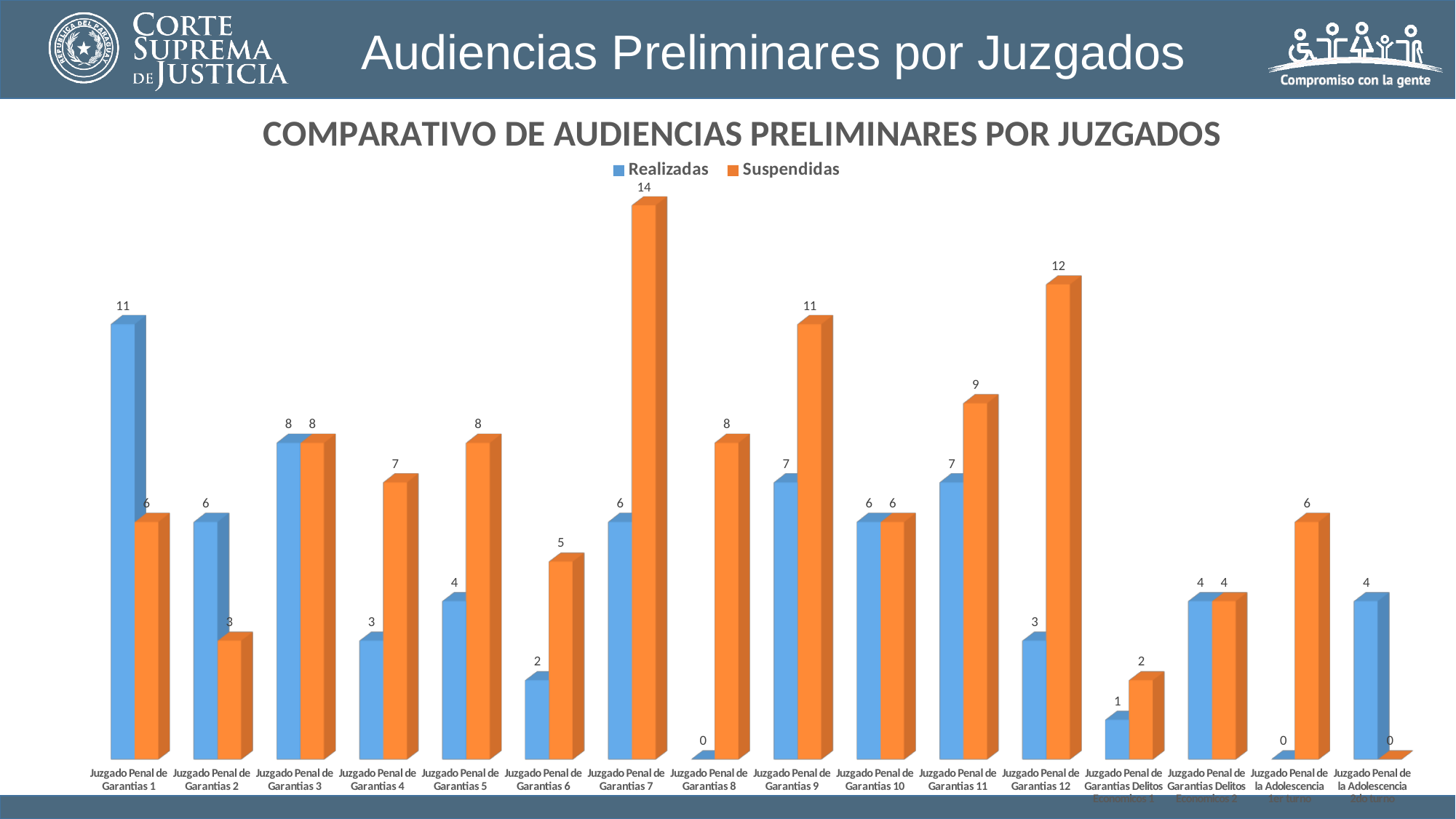
What is the difference between Suspendidas and Realizadas for Juzgado Penal de Garantias 7? 8 Which juzgado has the highest Suspendidas value? Juzgado Penal de Garantias 7 What kind of chart is shown on the slide? Bar chart What is the Suspendidas value for Juzgado Penal de Garantias 12? 12 What is the Realizadas value for Juzgado Penal de Garantias 8? 0 How many juzgados (categories) are shown on the x axis? 16 How many Realizadas audiencias does Juzgado Penal de Garantias 1 have? 11 For Juzgado Penal de Garantias 9, which is larger: Realizadas or Suspendidas? Suspendidas What is the total of Realizadas and Suspendidas for Juzgado Penal de Garantias 3? 16 What is the title of the chart? COMPARATIVO DE AUDIENCIAS PRELIMINARES POR JUZGADOS Which juzgado has the highest Realizadas value? Juzgado Penal de Garantias 1 How many series does the legend list? 2